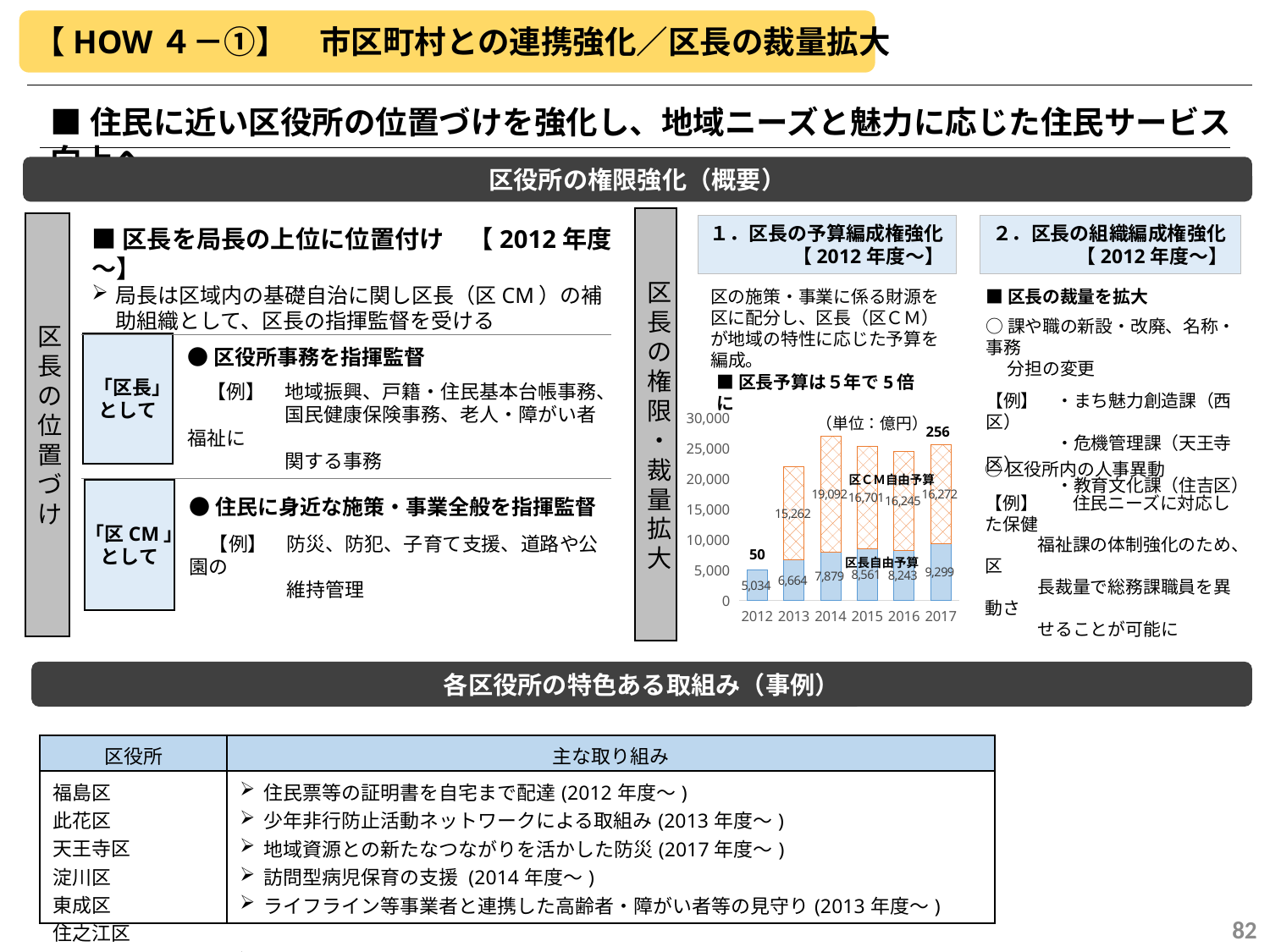
What is the total of the 2013 stacked bar (区長自由予算 plus 区CM自由予算)? 21,926 Which year has the lowest 区長自由予算 value in the bar chart? 2012 Is the total height of the 2014 stacked bar greater or less than 25,000? greater Which year has the highest 区長自由予算 value in the bar chart? 2017 Which year has the highest 区CM自由予算 value in the bar chart? 2014 How many years are shown on the x axis of the bar chart? 6 What is the difference between the 区長自由予算 values for 2017 and 2012? 4,265 What is the 区CM自由予算 value for 2017 in the bar chart? 16,272 What is the 区CM自由予算 value for 2014 in the bar chart? 19,092 What is the 区長自由予算 value for 2012 in the bar chart? 5,034 What kind of chart is used to show the 区長予算 data? bar chart Which is larger, the 区長自由予算 value for 2015 or for 2016? 2015